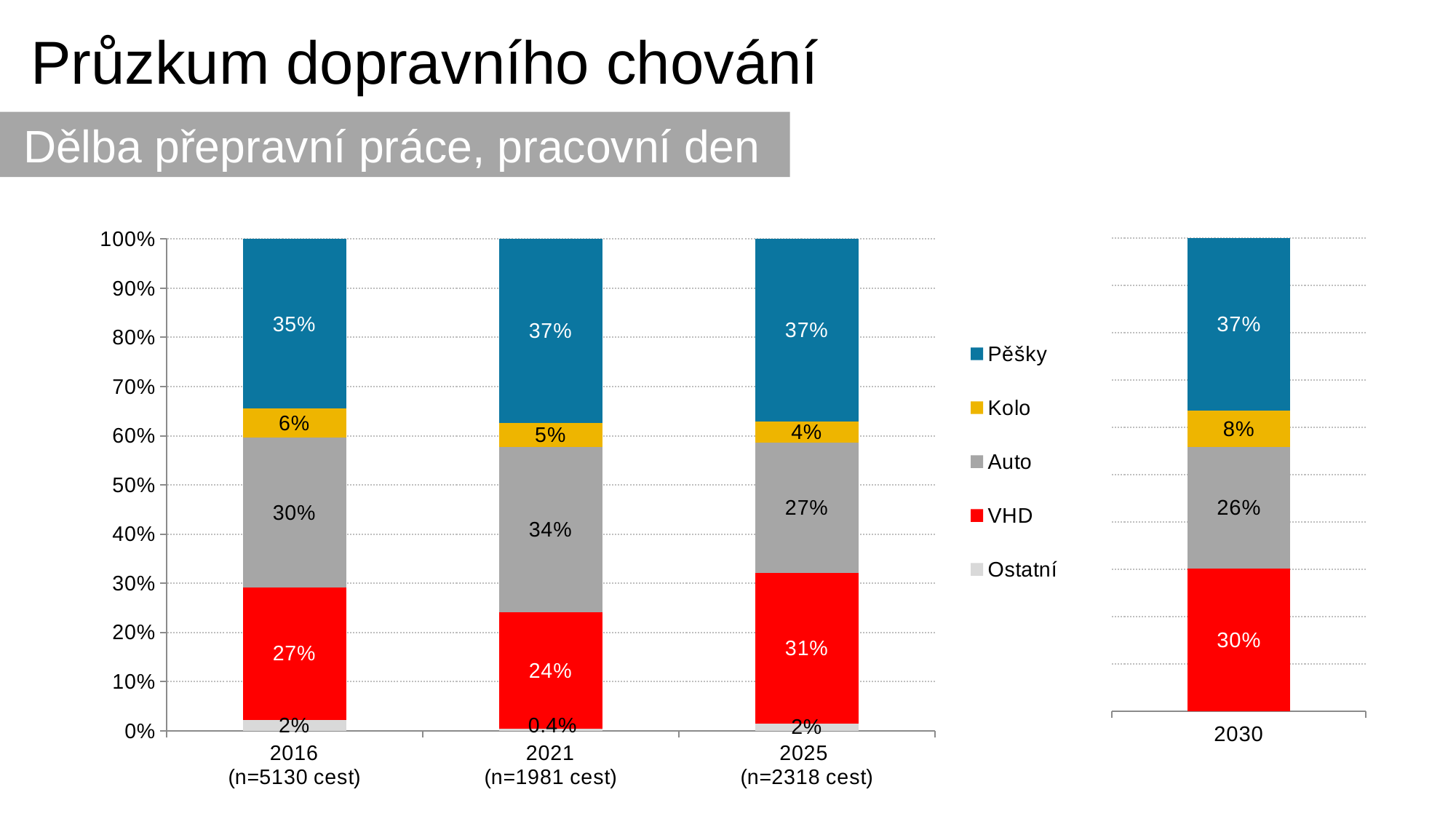
In the left chart, what is the value for Auto in 2021? 34% In the left chart, does the Kolo value rise or fall from 2016 to 2025? fall In the left chart, what is the difference between the VHD values for 2025 and 2021? 7% What kind of chart is shown on the slide? stacked bar chart How many years are shown on the x axis of the left chart? 3 In the right chart, what is the value for Kolo in 2030? 8% In the left chart, which year has the highest value for Auto? 2021 In the left chart, what is the value for VHD in 2025? 31% How many series does the legend list? 5 In the left chart, which year has the lowest value for Kolo? 2025 In the left chart, is the Pěšky value for 2016 larger or smaller than the Pěšky value for 2021? smaller In the left chart, what is the value for Ostatní in 2021? 0.4%